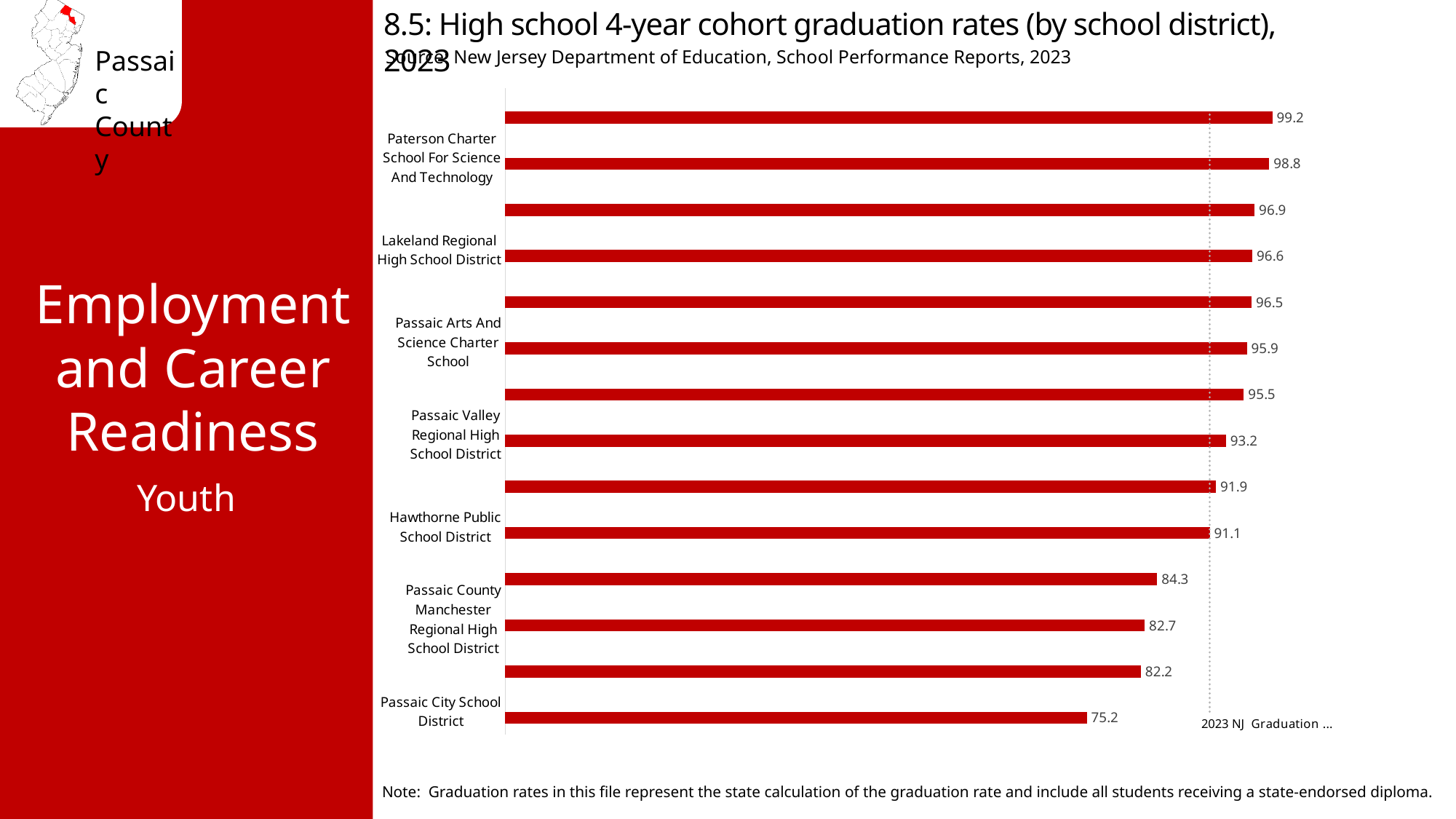
Which has a higher graduation rate, Lakeland Regional High School District or Passaic Valley Regional High School District? Lakeland Regional High School District How many bars are plotted in the chart? 14 What is the graduation rate for Paterson Charter School For Science And Technology? 98.8 What is the graduation rate for Hawthorne Public School District? 91.1 What source is cited for the chart data? New Jersey Department of Education, School Performance Reports, 2023 What type of chart is shown on the slide? Bar chart What is the difference between the graduation rates of Lakeland Regional High School District and Hawthorne Public School District? 5.5 What is the graduation rate for Passaic County Manchester Regional High School District? 82.7 What is the highest graduation rate shown in the chart? 99.2 Which school district has the lowest graduation rate in the chart? Passaic City School District What is the difference between the graduation rates of Paterson Charter School For Science And Technology and Passaic City School District? 23.6 What is the graduation rate for Passaic City School District? 75.2